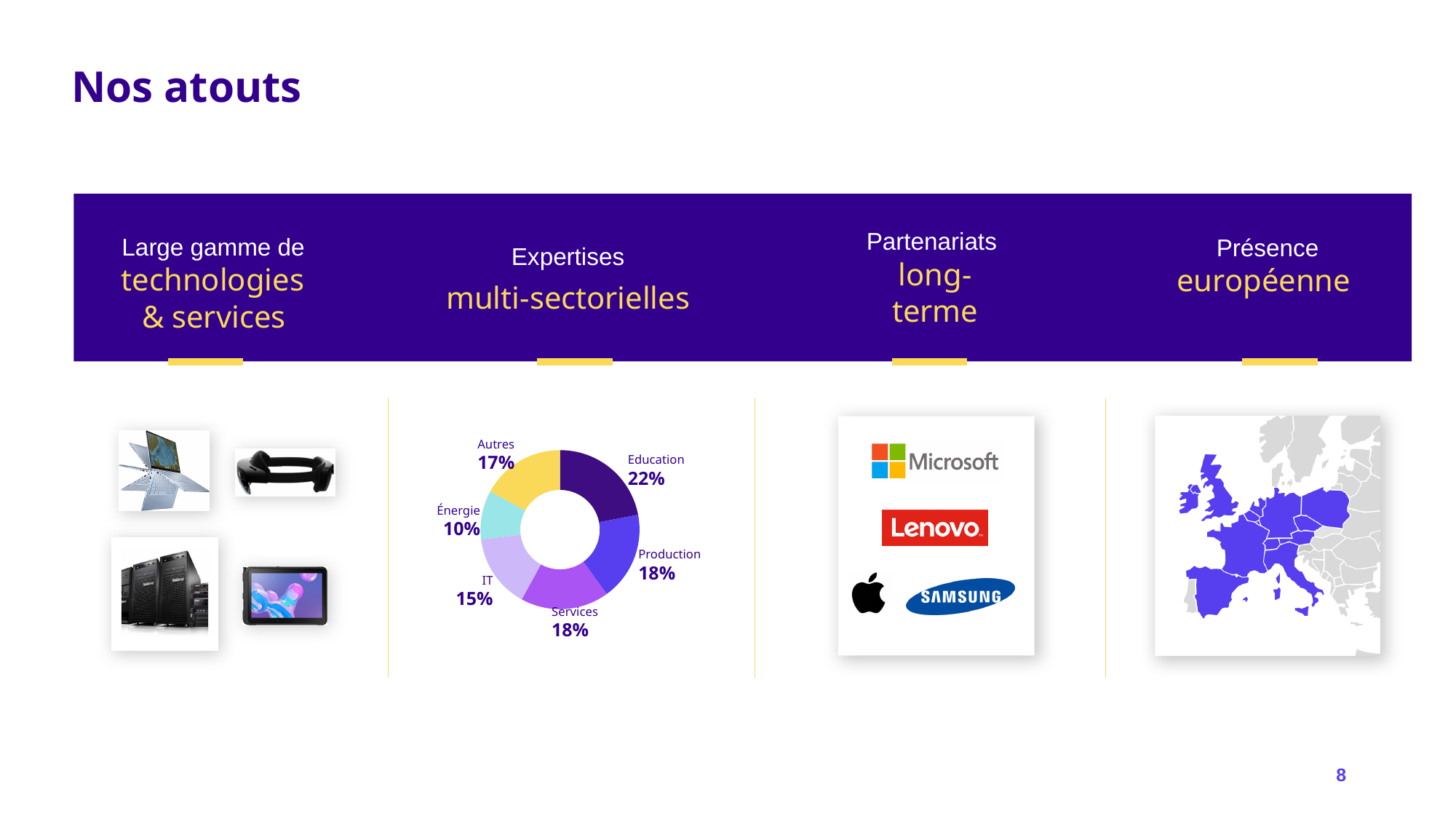
Which category has the smallest share in the donut chart? Énergie What share of the donut chart does Education represent? 22% What is the value shown for Énergie in the donut chart? 10% What is the combined share of Production and Services in the donut chart? 36% What is the difference between the Education share and the Énergie share in the donut chart? 12% Which category has the largest share in the donut chart? Education What is the value for Autres in the donut chart? 17% Which is larger in the donut chart, Autres or IT? Autres Which two categories in the donut chart share the same value of 18%? Production and Services What kind of chart is shown under 'Expertises multi-sectorielles'? Donut (pie) chart How many categories are shown in the donut chart? 6 What percentage is shown for IT in the donut chart? 15%